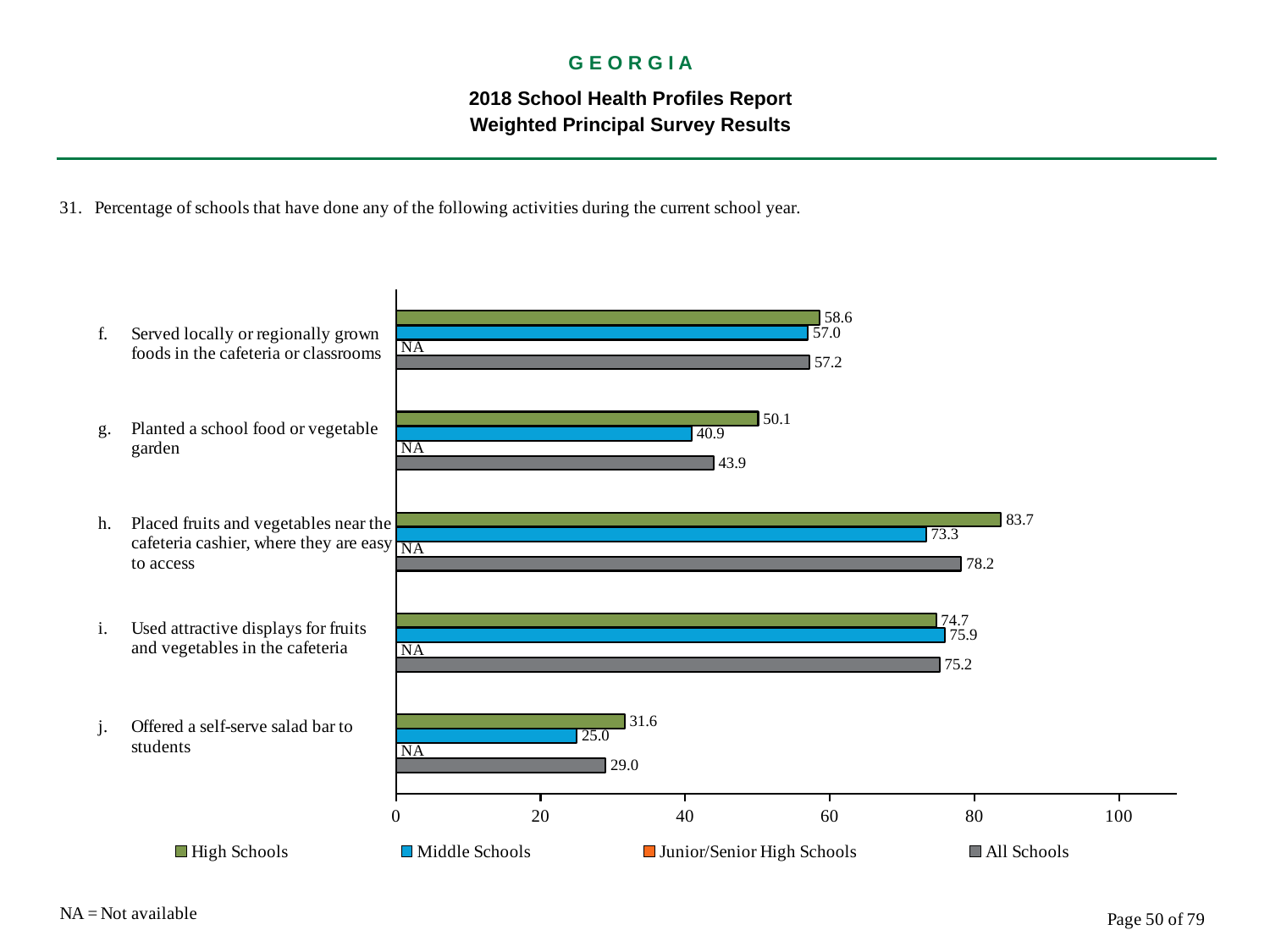
What is the difference between the High Schools and Middle Schools values for 'Placed fruits and vegetables near the cafeteria cashier'? 10.4 Is the All Schools value for 'Planted a school food or vegetable garden' greater or less than 60? less Which activity has the highest value for High Schools? Placed fruits and vegetables near the cafeteria cashier, where they are easy to access What is the All Schools value for 'Offered a self-serve salad bar to students'? 29.0 What percentage of high schools placed fruits and vegetables near the cafeteria cashier, where they are easy to access? 83.7 Which activity has the lowest value for Middle Schools? Offered a self-serve salad bar to students For 'Used attractive displays for fruits and vegetables in the cafeteria', which is larger: the High Schools value or the Middle Schools value? Middle Schools How many series does the legend list? 4 What kind of chart is shown on the slide? bar chart What value is shown for Junior/Senior High Schools for each activity? NA What is the value for Middle Schools for 'Planted a school food or vegetable garden'? 40.9 How many activities (categories) are shown on the chart? 5